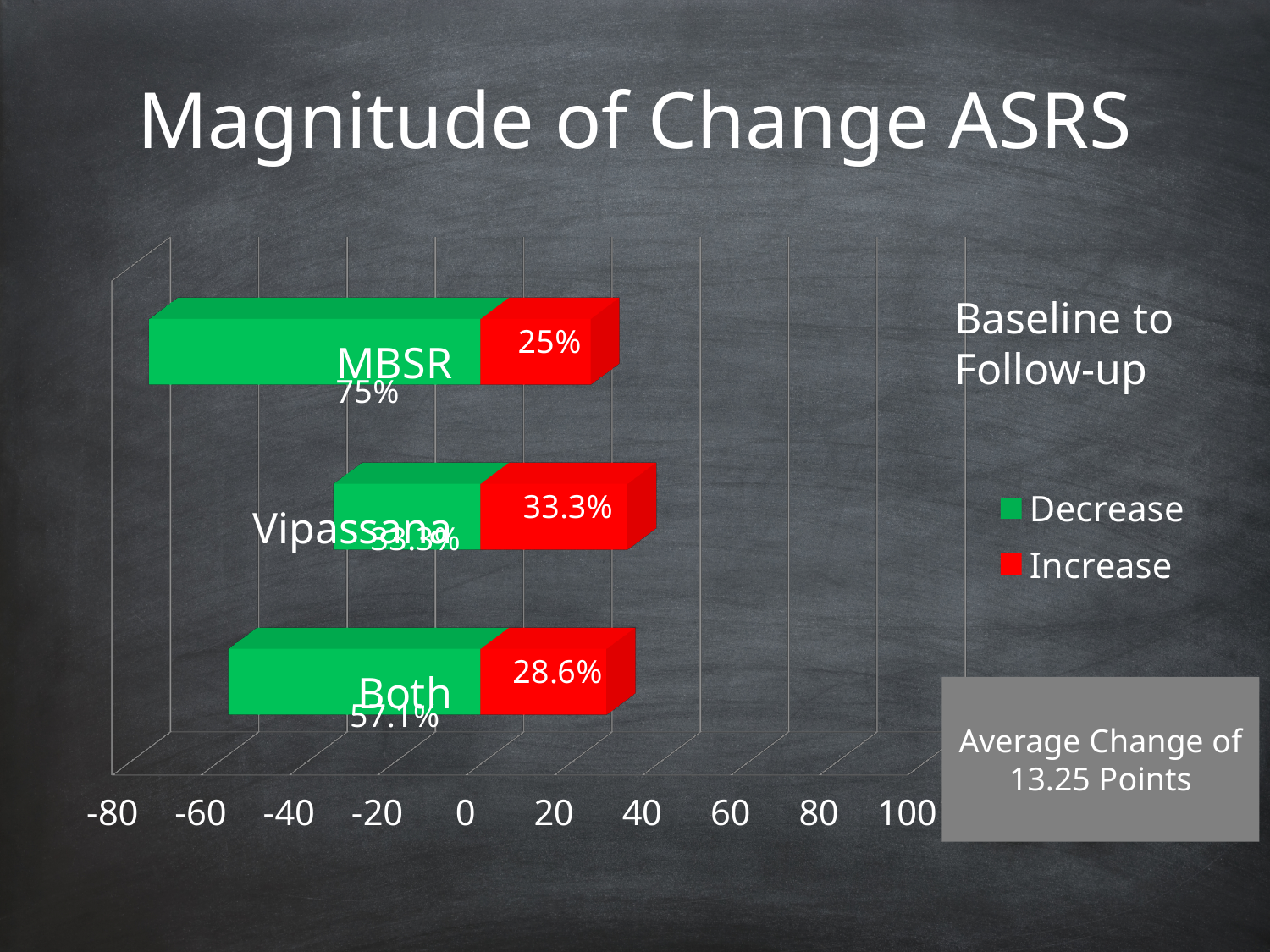
Is the Increase value for Vipassana larger or smaller than the Increase value for Both? larger How many series does the legend list? 2 Which category has the highest Decrease value? MBSR What is the difference between the Decrease and Increase values for MBSR? 50 percentage points Which category has the lowest Decrease value? Vipassana What is the Increase value for Both? 28.6% What is the Decrease value for Both? 57.1% What type of chart is shown on the slide? bar chart What is the Decrease value for MBSR? 75% Which category has the lowest Increase value? MBSR What is the Increase value for Vipassana? 33.3% How many categories are shown on the chart? 3